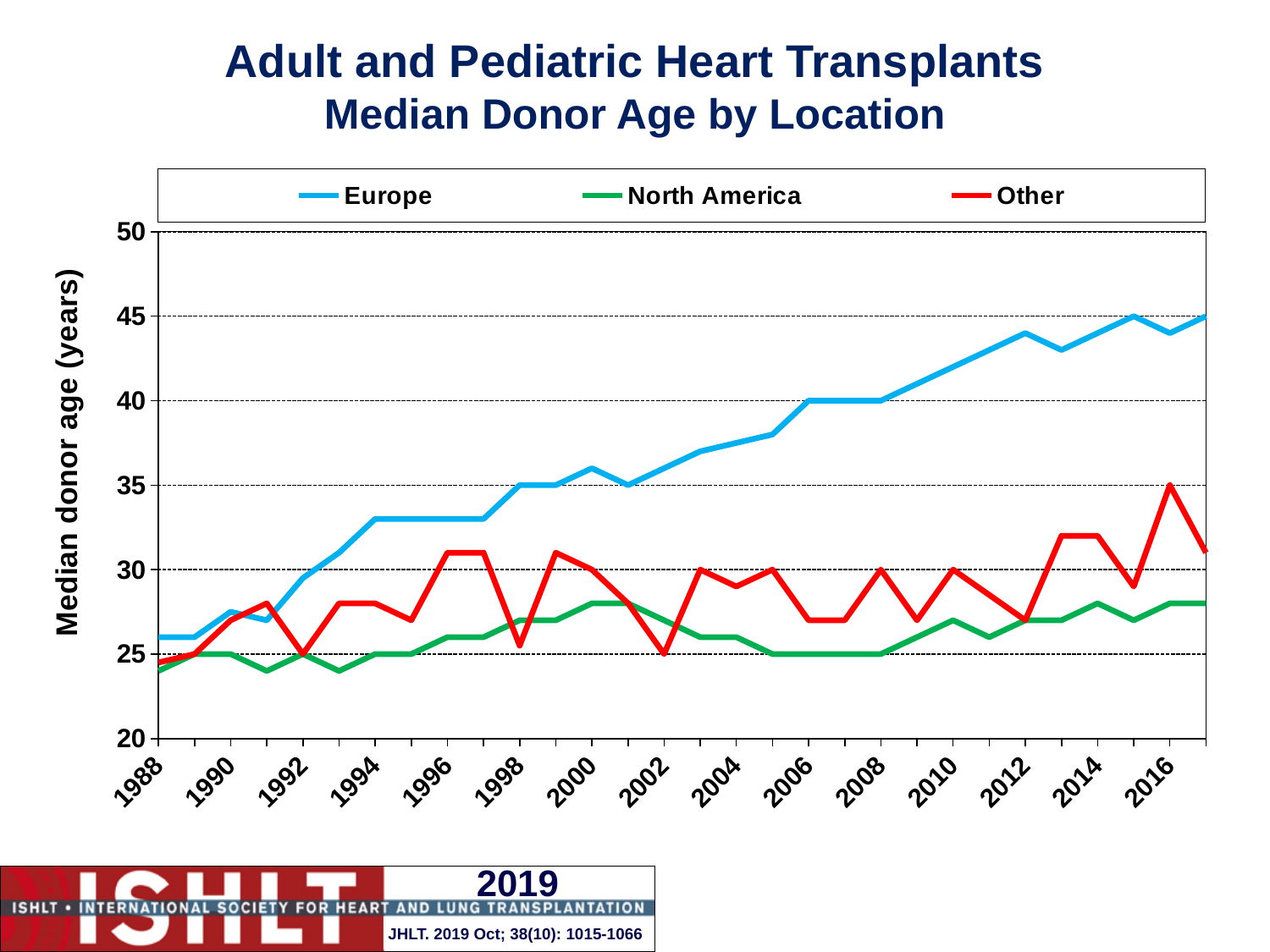
Is the median donor age for Europe in 2012 greater or less than 40? greater In 2010, which is larger: the median donor age for Europe or for Other? Europe In 2016, which is larger: the median donor age for Other or for North America? Other What is the label of the y axis? Median donor age (years) Does the median donor age for Europe rise or fall from 1988 to 2017? rise Which series has the highest median donor age in 2017? Europe Is the median donor age for Other in 2016 greater or less than 30? greater What kind of chart is shown on the slide? line chart What colour is the line for North America? green Is the median donor age for North America in 2017 greater or less than 30? less How many series does the legend list? 3